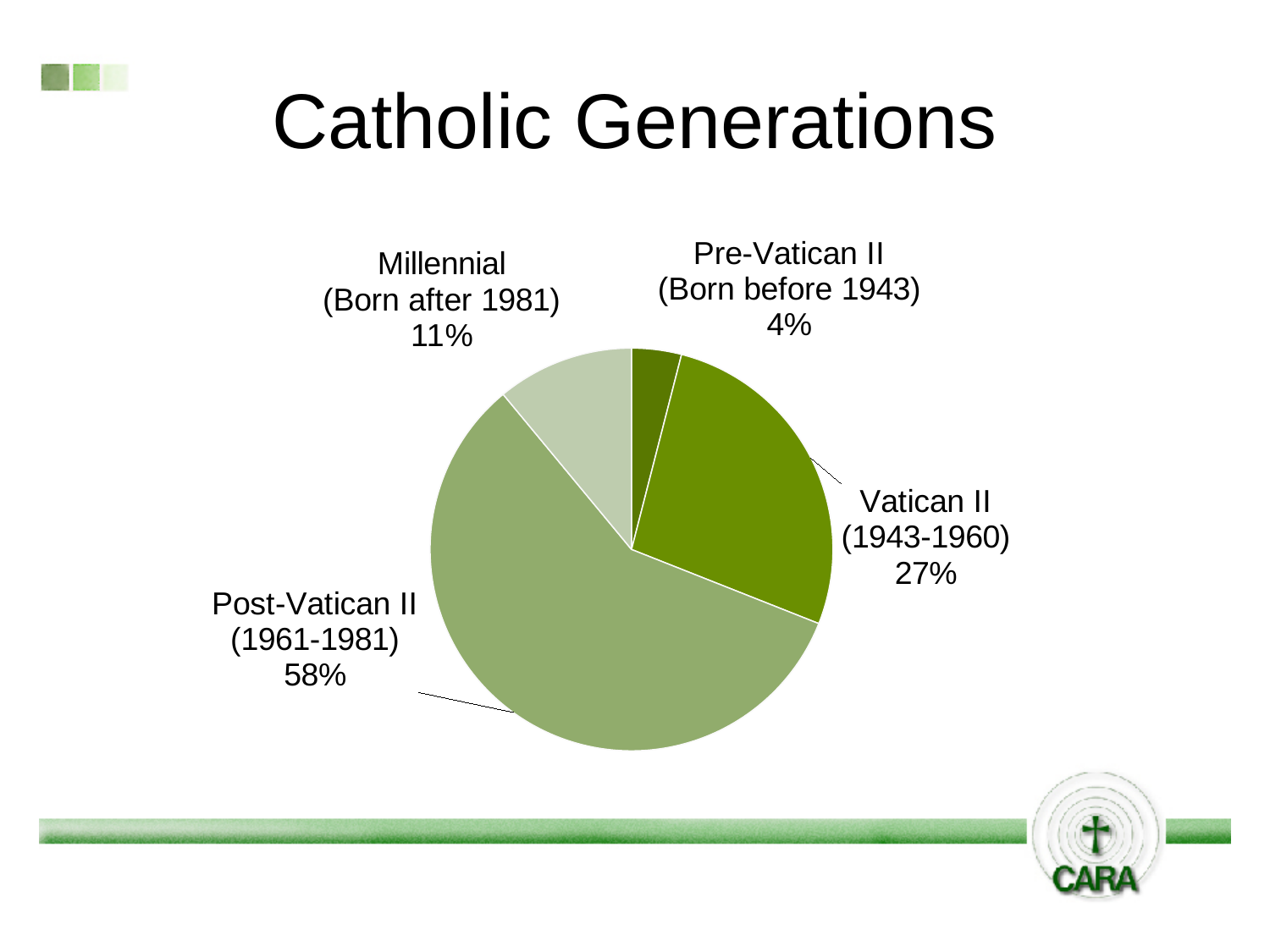
What kind of chart is shown on the slide? Pie chart What is the title of the chart? Catholic Generations What is the difference in percentage points between the Post-Vatican II and Vatican II generations? 31 What is the difference in percentage points between the Millennial and Pre-Vatican II generations? 7 Which is larger, the share for Vatican II or the share for Millennial? Vatican II What percentage is shown for the Vatican II (1943-1960) generation? 27% How many generations (slices) are shown in the pie chart? 4 Which generation has the largest share of the pie? Post-Vatican II (1961-1981) What percentage is shown for the Pre-Vatican II (Born before 1943) generation? 4% Which generation has the smallest share of the pie? Pre-Vatican II (Born before 1943) What share of the pie does the Post-Vatican II (1961-1981) generation hold? 58% What percentage is shown for the Millennial (Born after 1981) generation? 11%